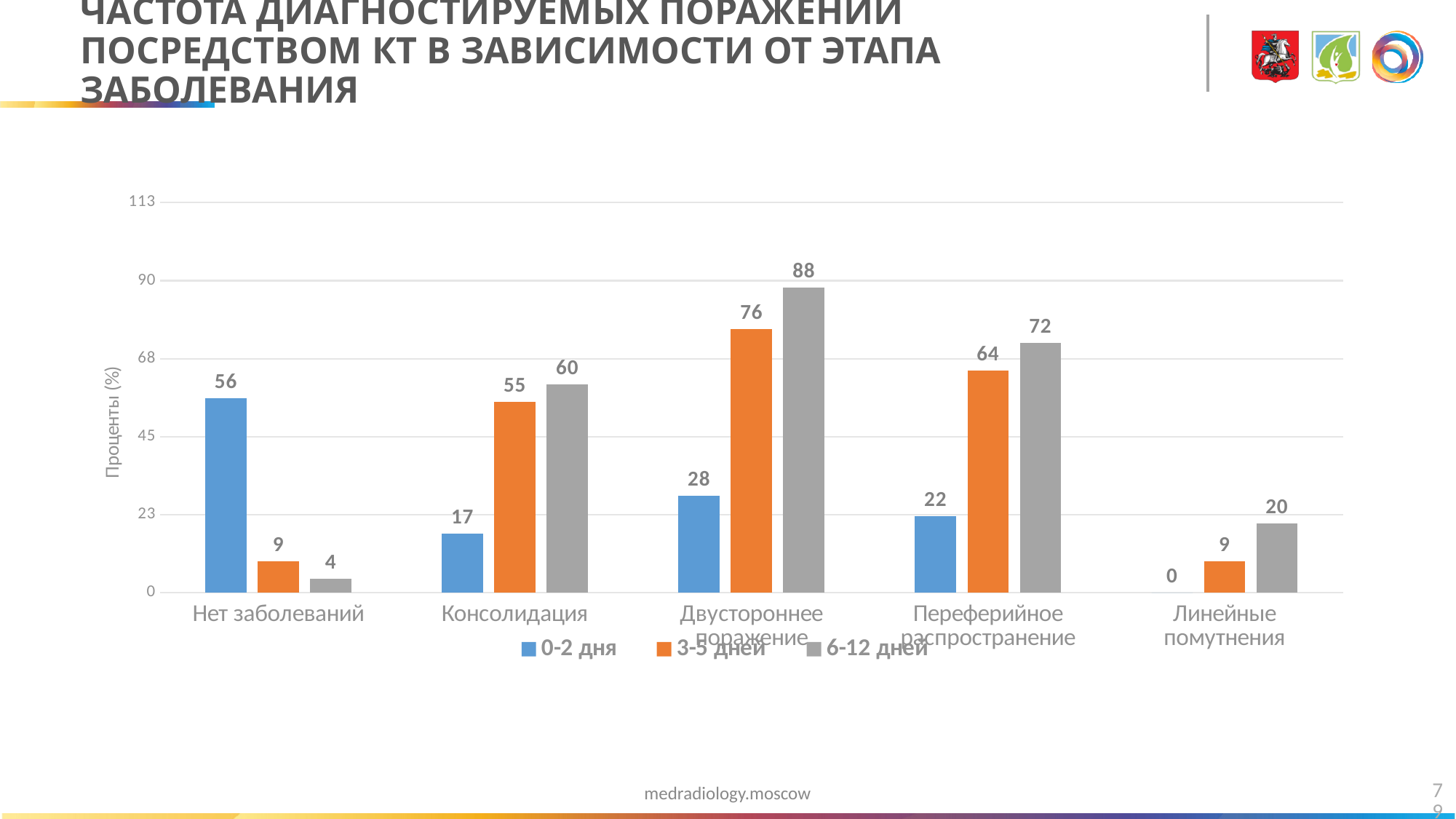
How many categories are shown on the x axis? 5 What is the value for 0-2 дня in the Линейные помутнения category? 0 Which category has the highest value for the 6-12 дней series? Двустороннее поражение What is the value for 6-12 дней in the Двустороннее поражение category? 88 In the Двустороннее поражение category, which is larger: the 0-2 дня value or the 3-5 дней value? 3-5 дней What is the label of the y axis? Проценты (%) What is the value for 3-5 дней in the Переферийное распространение category? 64 What kind of chart is shown on the slide? Bar chart What is the value for 0-2 дня in the Нет заболеваний category? 56 What is the difference between the 6-12 дней and 3-5 дней values in the Консолидация category? 5 Which category has the lowest value for the 3-5 дней series? Нет заболеваний and Линейные помутнения (both 9) How many series does the legend list? 3